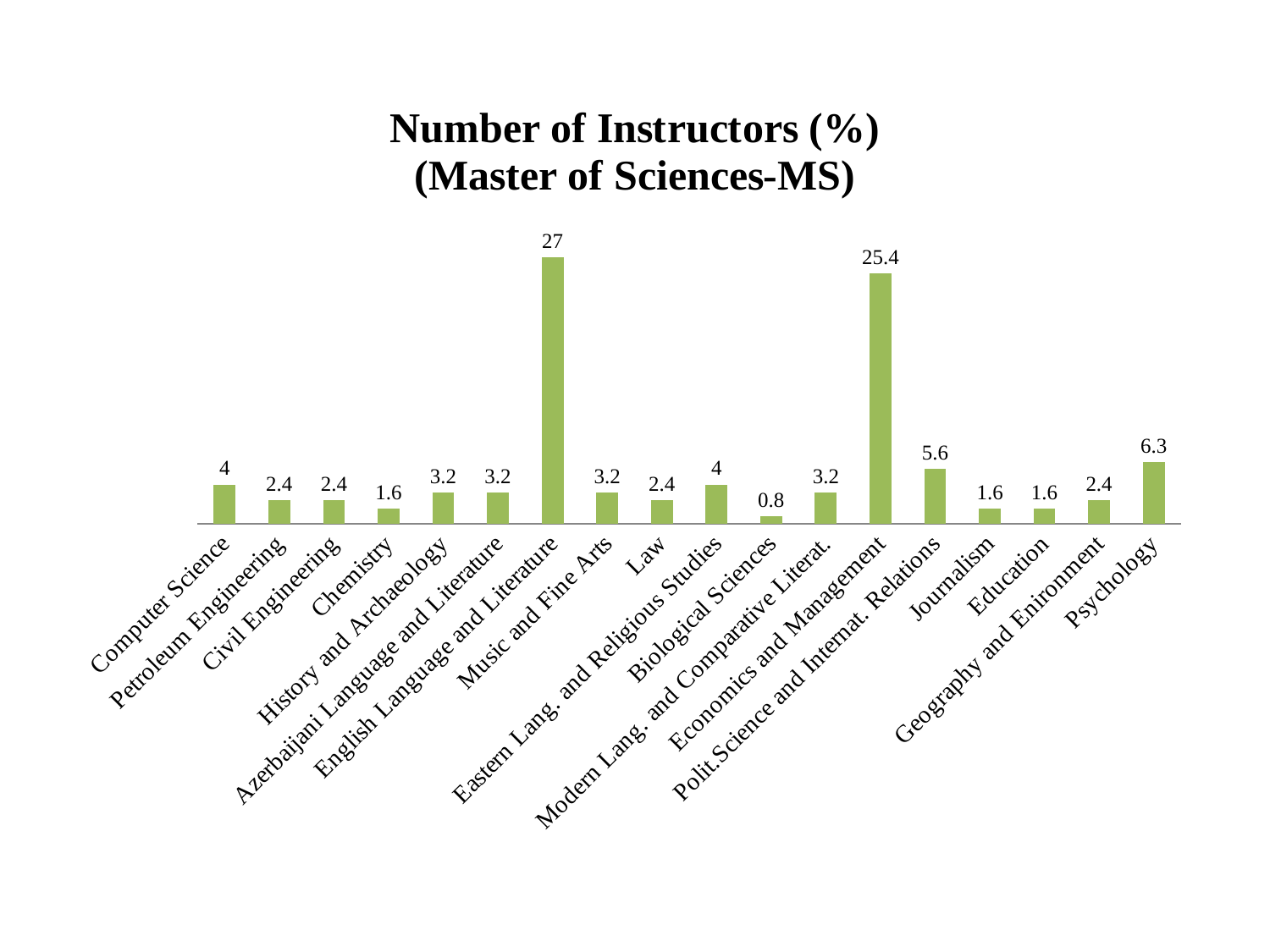
What is the value for Psychology? 6.3 What is the value for Polit.Science and Internat. Relations? 5.6 Which category has the lowest value? Biological Sciences How many categories are shown in the chart? 18 What is the title of the chart? Number of Instructors (%) (Master of Sciences-MS) Which is larger, the value for Psychology or the value for Polit.Science and Internat. Relations? Psychology What is the difference between the values for English Language and Literature and Economics and Management? 1.6 What is the value for Economics and Management? 25.4 What is the value for English Language and Literature? 27 What is the value for Biological Sciences? 0.8 What kind of chart is shown on the slide? Bar chart Which category has the highest value? English Language and Literature